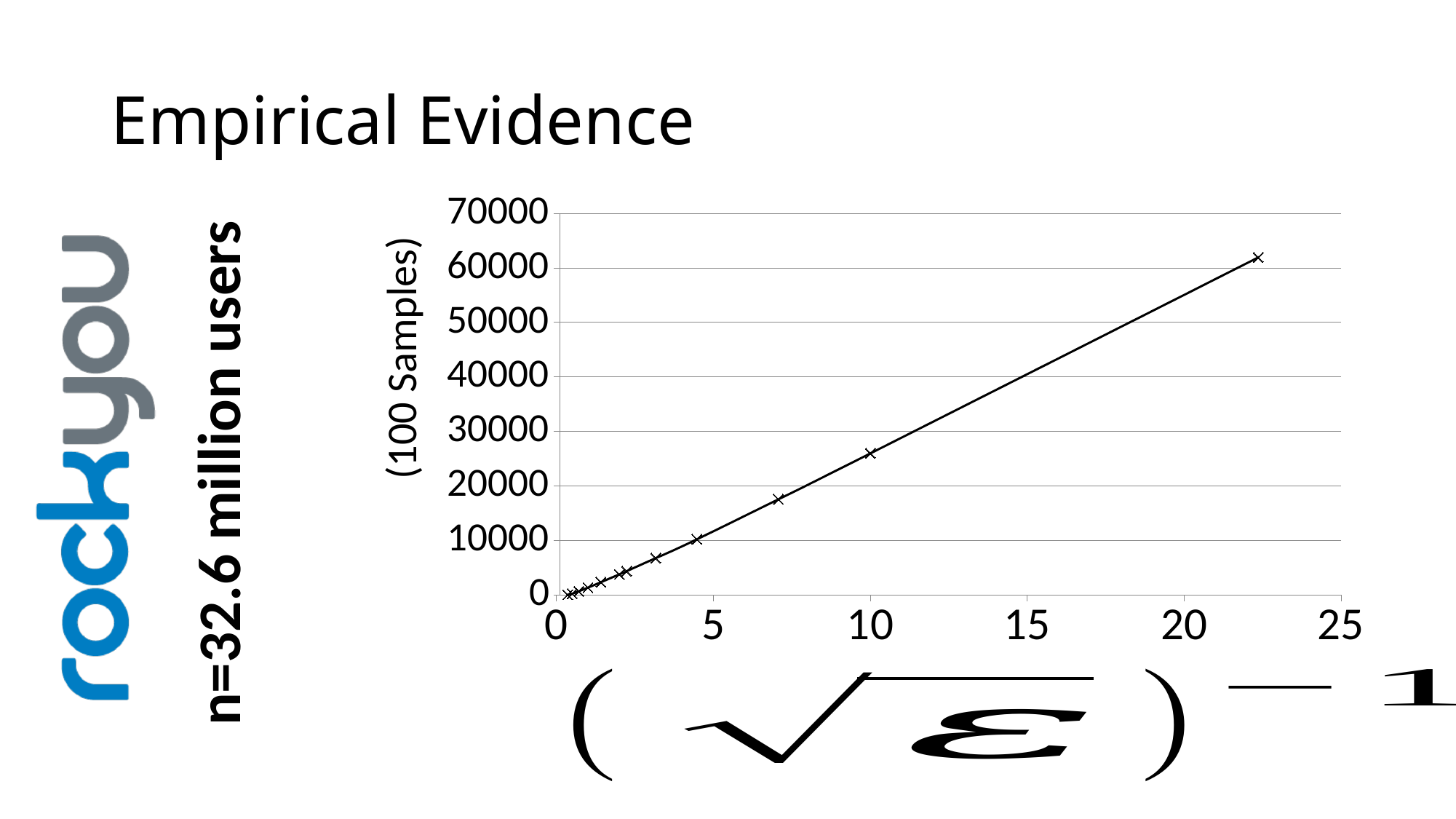
Is the value of the data point at x = 10 greater or less than 20000? greater Is the value of the data point at x = 10 greater or less than 30000? less Do the plotted values rise or fall as the x-axis value increases? rise Is the value of the data point near x = 3 greater or less than 10000? less What is the label on the vertical axis of the chart? (100 Samples) Which data point has the highest value, the one near x = 22.5 or the one at x = 10? the one near x = 22.5 What is the highest tick value shown on the vertical axis? 70000 What kind of chart is shown on the slide? line chart